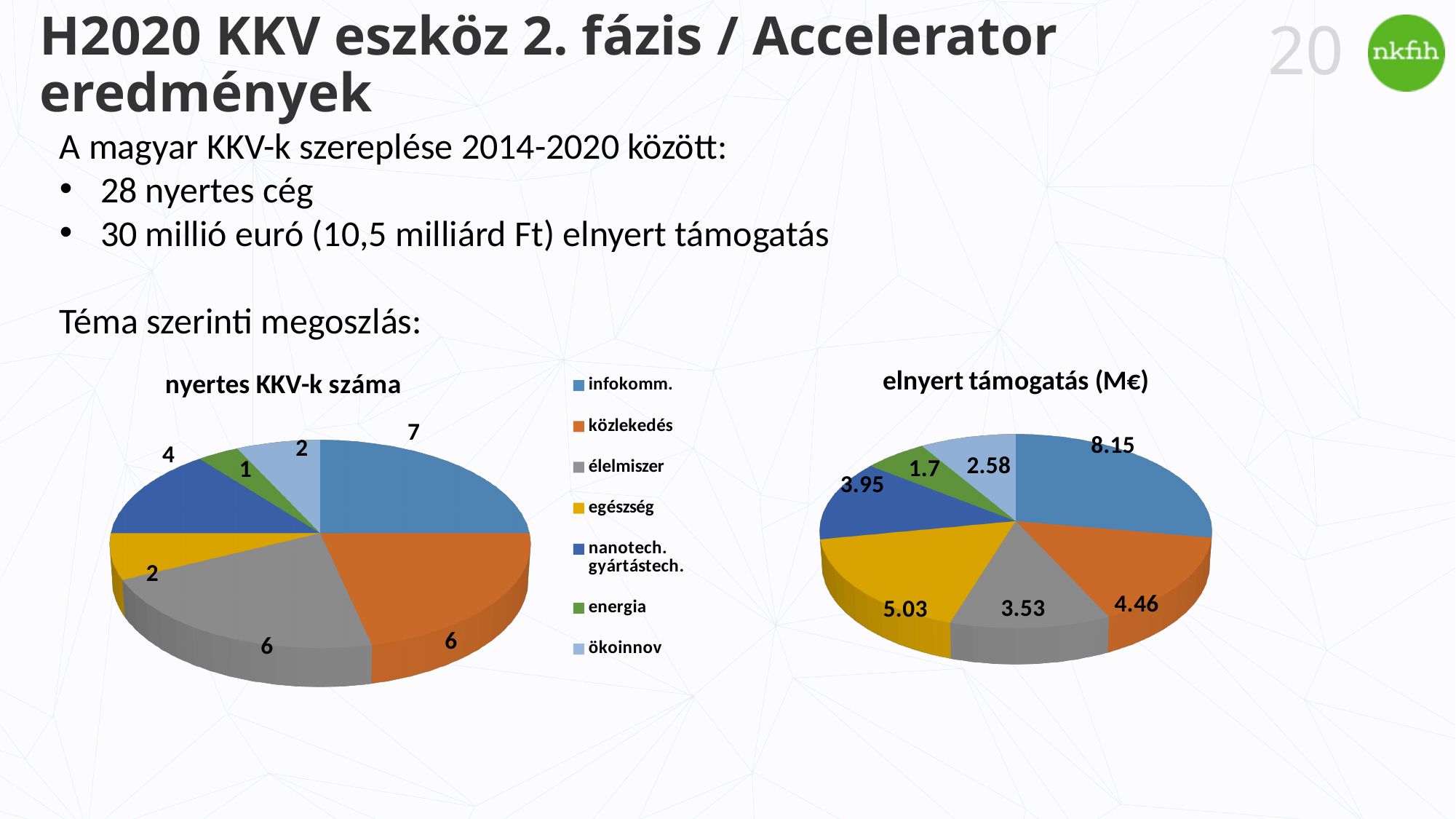
Which colour represents közlekedés in the legend? orange What kind of chart is the 'elnyert támogatás (M€)' chart? pie chart How many categories does the 'nyertes KKV-k száma' chart show? 7 In the 'elnyert támogatás (M€)' chart, which is larger: egészség or élelmiszer? egészség In the 'nyertes KKV-k száma' chart, what is the value for infokomm.? 7 In the 'elnyert támogatás (M€)' chart, what is the difference between infokomm. and közlekedés? 3.69 In the 'nyertes KKV-k száma' chart, what share of the total does infokomm. represent? 25% In the 'elnyert támogatás (M€)' chart, what is the value for egészség? 5.03 In the 'nyertes KKV-k száma' chart, which category has the lowest value? energia In the 'elnyert támogatás (M€)' chart, what is the value for nanotech. gyártástech.? 3.95 In the 'elnyert támogatás (M€)' chart, which category has the highest value? infokomm. In the 'nyertes KKV-k száma' chart, what is the difference between nanotech. gyártástech. and energia? 3